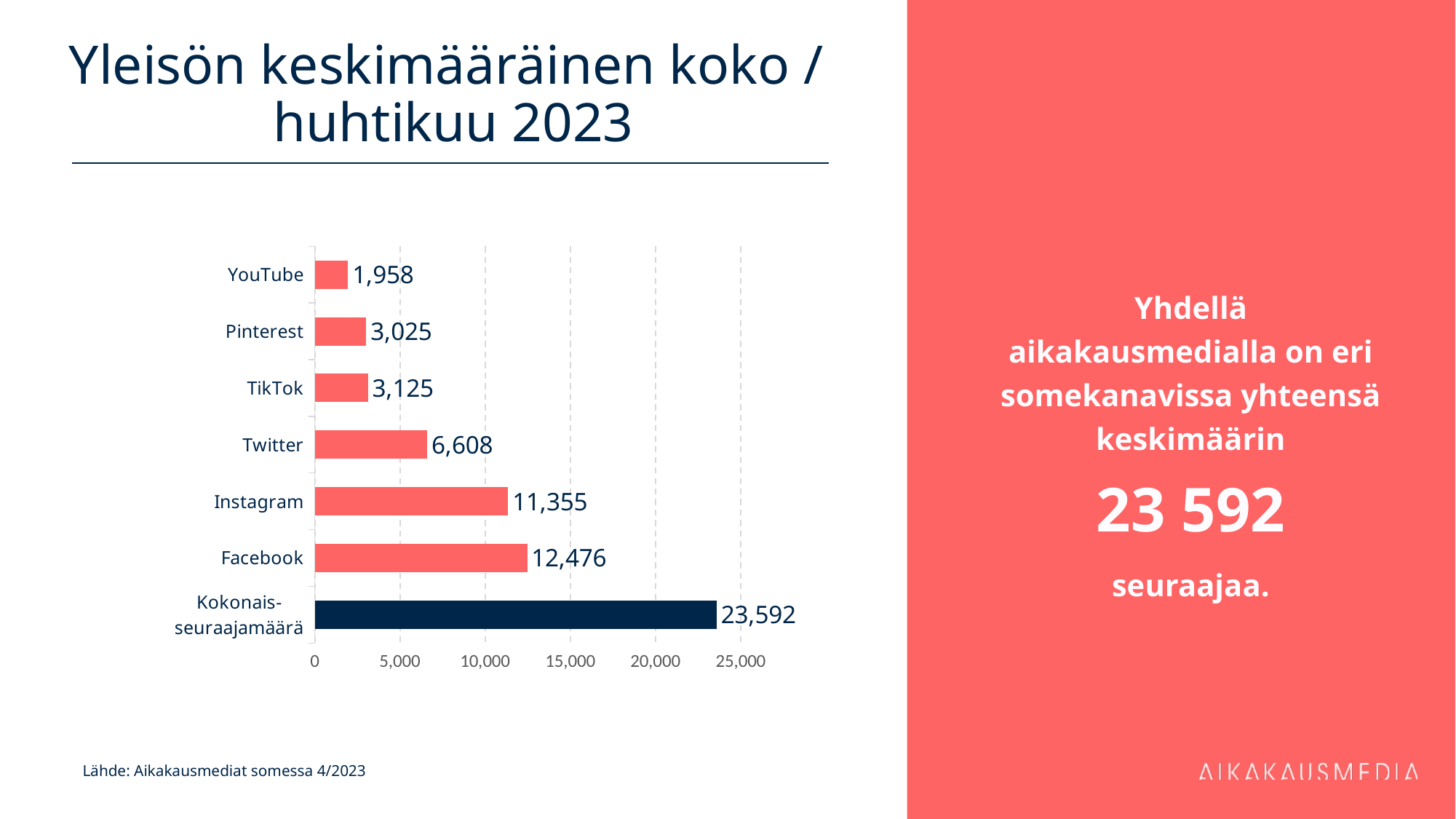
What kind of chart is shown on the slide? Bar chart What is the value for YouTube? 1,958 Which bar is shown in a different colour (dark navy) from the others? Kokonais-seuraajamäärä What is the value for Instagram? 11,355 Which is larger, the value for Pinterest or the value for Twitter? Twitter What is the value for Facebook? 12,476 How many categories are shown in the chart? 7 What is the difference between the values for Twitter and TikTok? 3,483 Which category has the lowest value? YouTube What is the value for Kokonais-seuraajamäärä? 23,592 What is the difference between the values for Facebook and Instagram? 1,121 Which category has the highest value? Kokonais-seuraajamäärä